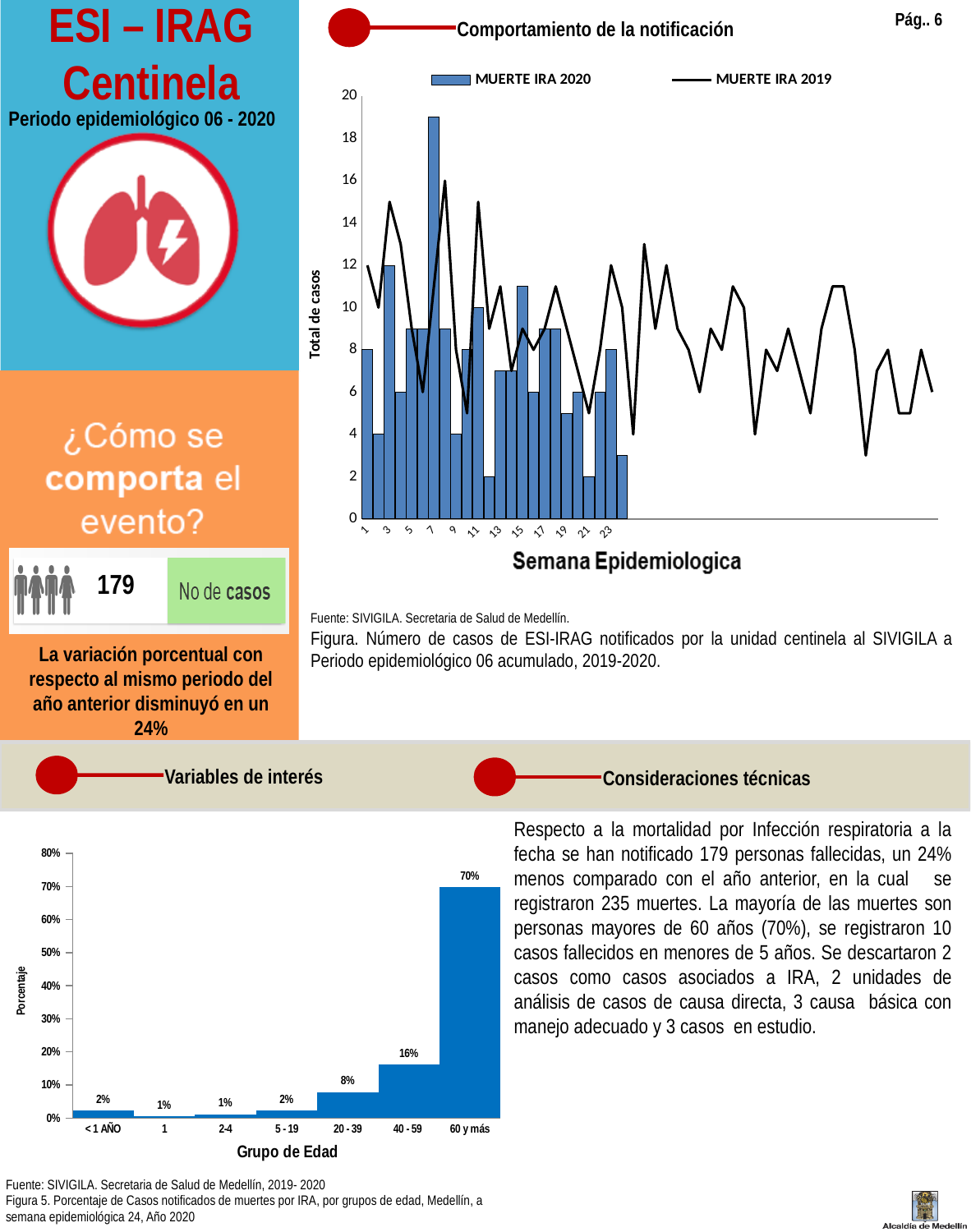
In the bottom chart by age group, what percentage is shown for the '20 - 39' group? 8% In the top chart 'Comportamiento de la notificación', is the MUERTE IRA 2020 bar for week 12 greater or less than 4? less What kind of chart is the bottom chart by age group? Bar chart In the top chart 'Comportamiento de la notificación', how many series does the legend list? 2 In the top chart 'Comportamiento de la notificación', what is the title of the y axis? Total de casos In the bottom chart by age group, what is the difference in percentage points between the '60 y más' group and the '40 - 59' group? 54% In the bottom chart by age group (Grupo de Edad), what percentage is shown for the '60 y más' group? 70% In the bottom chart by age group, how many age groups are shown on the x axis? 7 In the bottom chart by age group, which has the larger percentage: '20 - 39' or '5 - 19'? 20 - 39 In the top chart 'Comportamiento de la notificación', is the MUERTE IRA 2020 bar for week 7 greater or less than 16? greater In the bottom chart by age group, what percentage is shown for the '40 - 59' group? 16% In the bottom chart by age group, which age group has the highest percentage? 60 y más